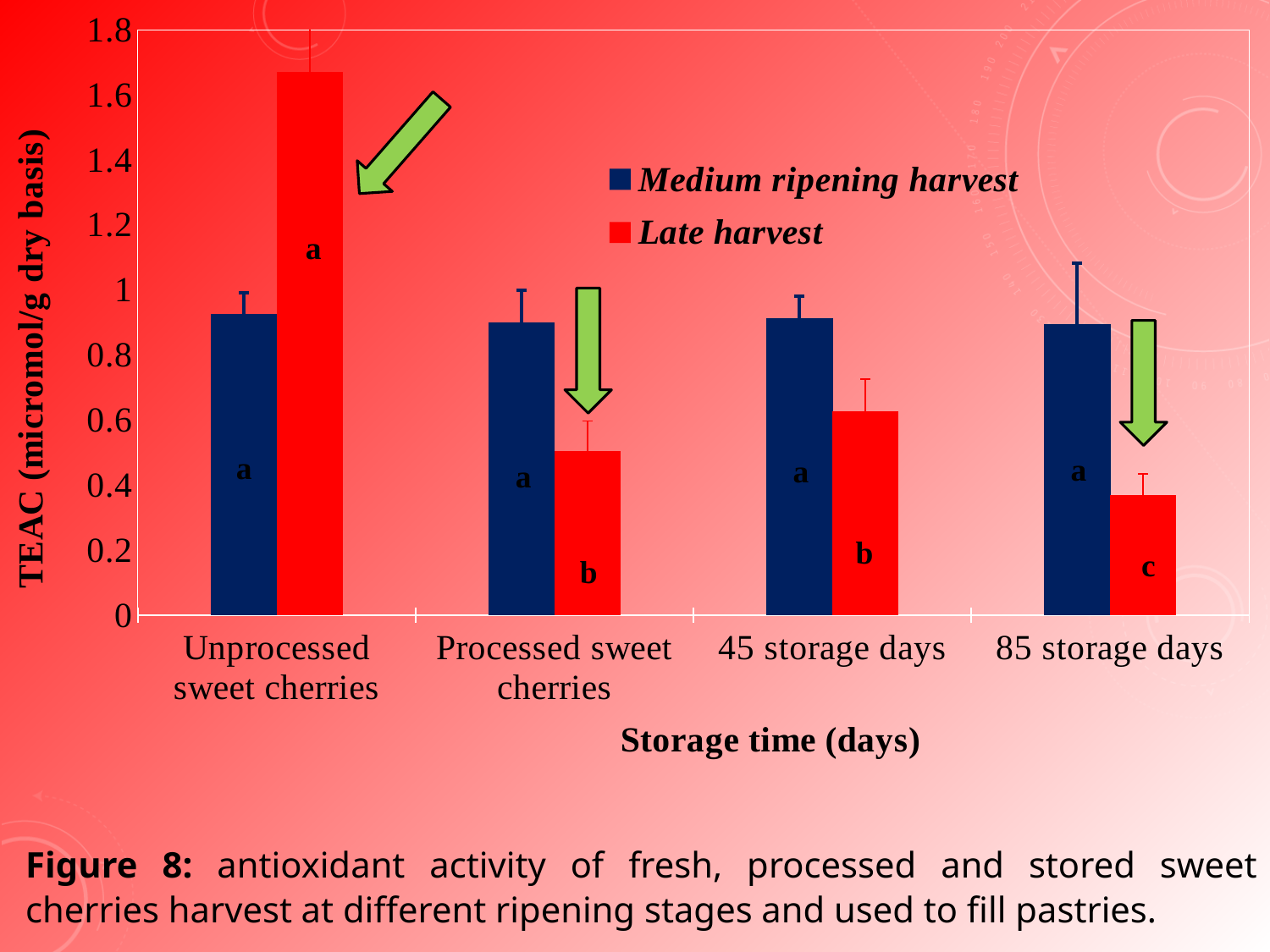
How many series does the legend list? 2 What kind of chart is shown on the slide? Bar chart Is the Late harvest value for Unprocessed sweet cherries greater or less than 1.4? greater Which colour represents the Late harvest series? Red How many categories are shown along the x axis? 4 What is the label of the y axis? TEAC (micromol/g dry basis) Is the Late harvest value for Processed sweet cherries greater or less than 0.6? less Is the Late harvest value at 45 storage days greater or less than 0.8? less For which category is the Late harvest value highest? Unprocessed sweet cherries For Unprocessed sweet cherries, which series has the larger value, Medium ripening harvest or Late harvest? Late harvest For which category is the Late harvest value lowest? 85 storage days For Processed sweet cherries, which series has the larger value, Medium ripening harvest or Late harvest? Medium ripening harvest